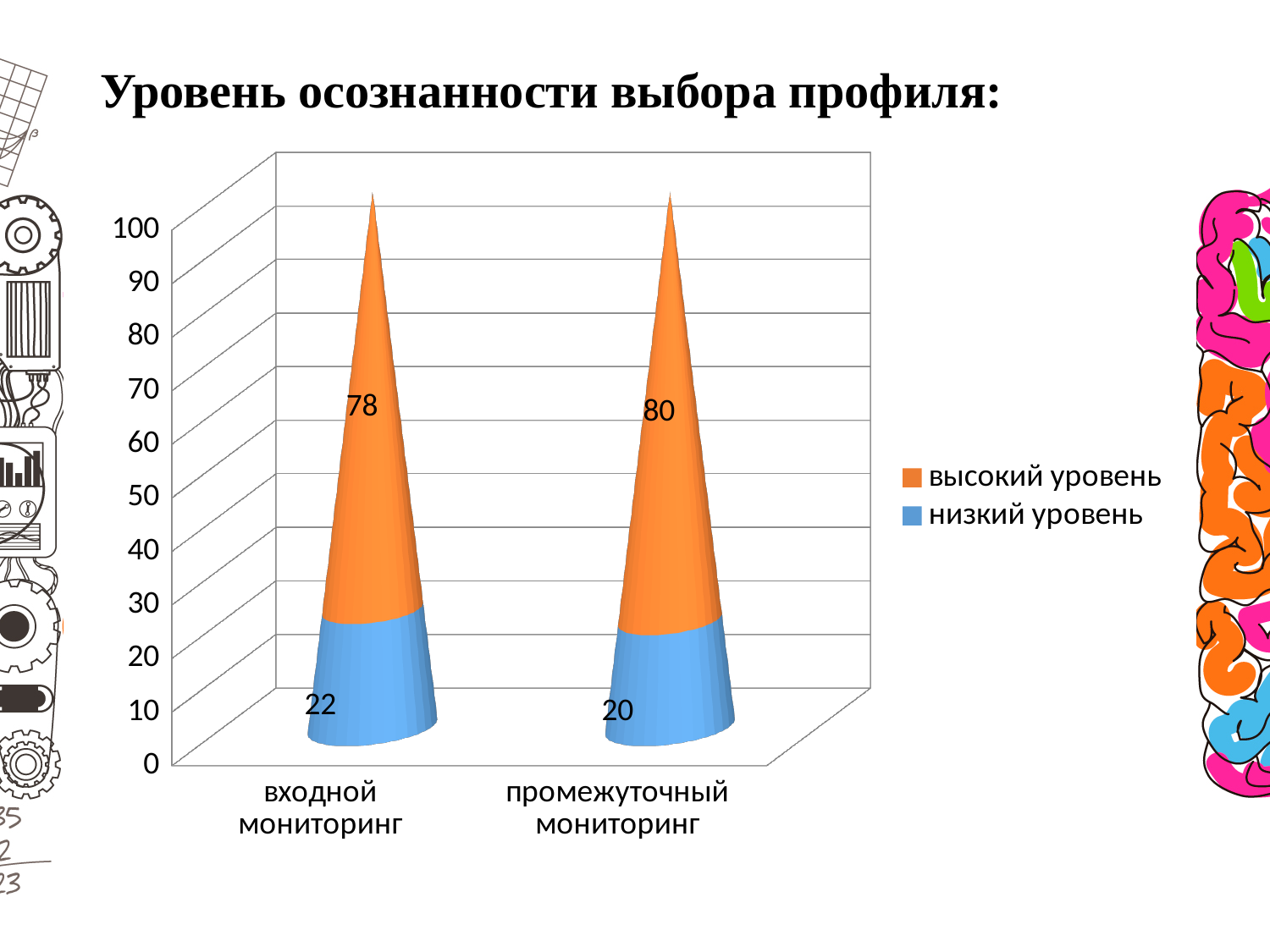
In which category is the "низкий уровень" value lowest? промежуточный мониторинг What is the value for "низкий уровень" in the "входной мониторинг" category? 22 What is the value for "высокий уровень" in the "входной мониторинг" category? 78 In which category is the "высокий уровень" value highest? промежуточный мониторинг What is the value for "высокий уровень" in the "промежуточный мониторинг" category? 80 What is the title of the chart on the slide? Уровень осознанности выбора профиля: How many categories are shown on the x axis? 2 Which is larger: "низкий уровень" for "входной мониторинг" or "низкий уровень" for "промежуточный мониторинг"? входной мониторинг What is the value for "низкий уровень" in the "промежуточный мониторинг" category? 20 What is the total of the stacked bar for "входной мониторинг"? 100 What is the difference between the "высокий уровень" values for "промежуточный мониторинг" and "входной мониторинг"? 2 How many series does the legend list? 2